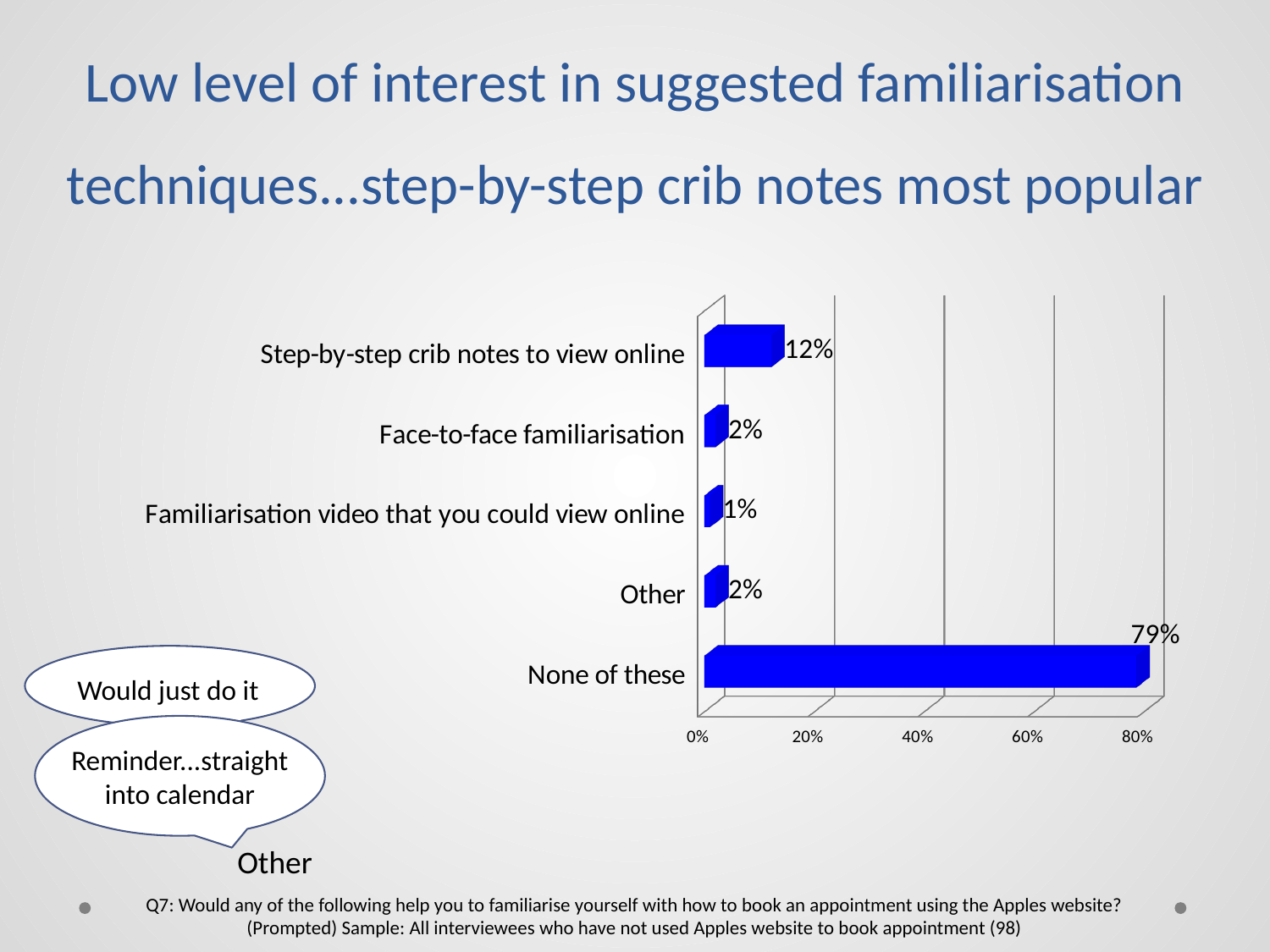
What is the value for 'Familiarisation video that you could view online'? 1% Is the value for 'None of these' greater or less than 60%? greater What percentage of respondents chose 'Step-by-step crib notes to view online'? 12% Which category has the highest value? None of these What type of chart is shown on the slide? Bar chart What percentage chose 'Face-to-face familiarisation'? 2% Which category has the lowest value? Familiarisation video that you could view online What colour are the bars in the chart? Blue What is the value for 'None of these'? 79% Which is larger: 'Step-by-step crib notes to view online' or 'Face-to-face familiarisation'? Step-by-step crib notes to view online How many categories are shown in the chart? 5 What is the difference between 'None of these' and 'Step-by-step crib notes to view online'? 67%